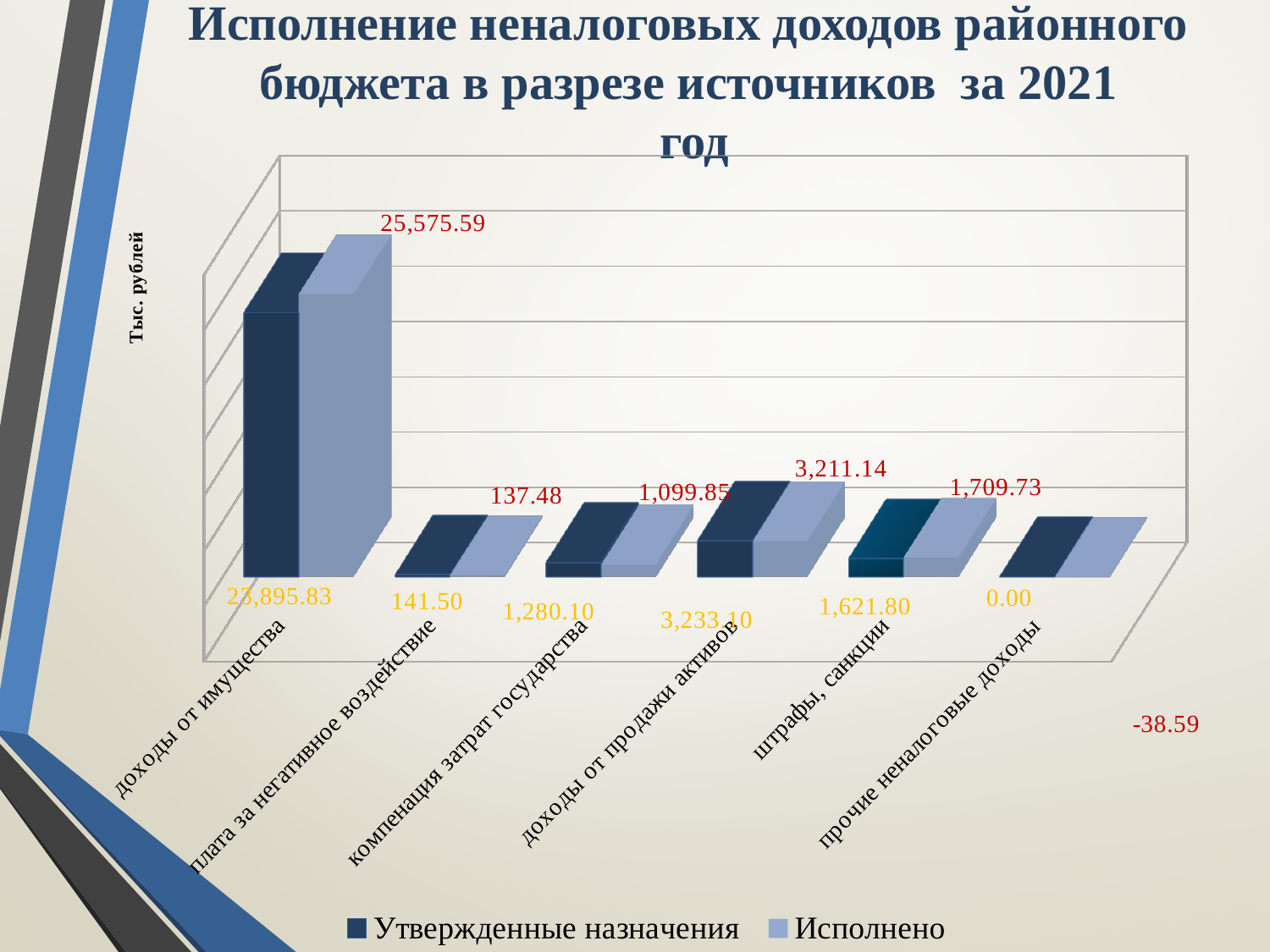
What is the value of Исполнено for доходы от имущества? 25,575.59 For штрафы, санкции, which is larger: Утвержденные назначения or Исполнено? Исполнено What is the value of Утвержденные назначения for доходы от имущества? 23,895.83 How many series does the legend list? 2 What type of chart is shown on the slide? bar chart What is the value of Исполнено for прочие неналоговые доходы? -38.59 Which category has the highest Исполнено value? доходы от имущества Which category has the lowest Утвержденные назначения value? прочие неналоговые доходы How many categories are shown on the x axis? 6 What is the value of Утвержденные назначения for штрафы, санкции? 1,621.80 What is the difference between Утвержденные назначения and Исполнено for компенсация затрат государства? 180.25 What unit is given on the vertical axis title? Тыс. рублей